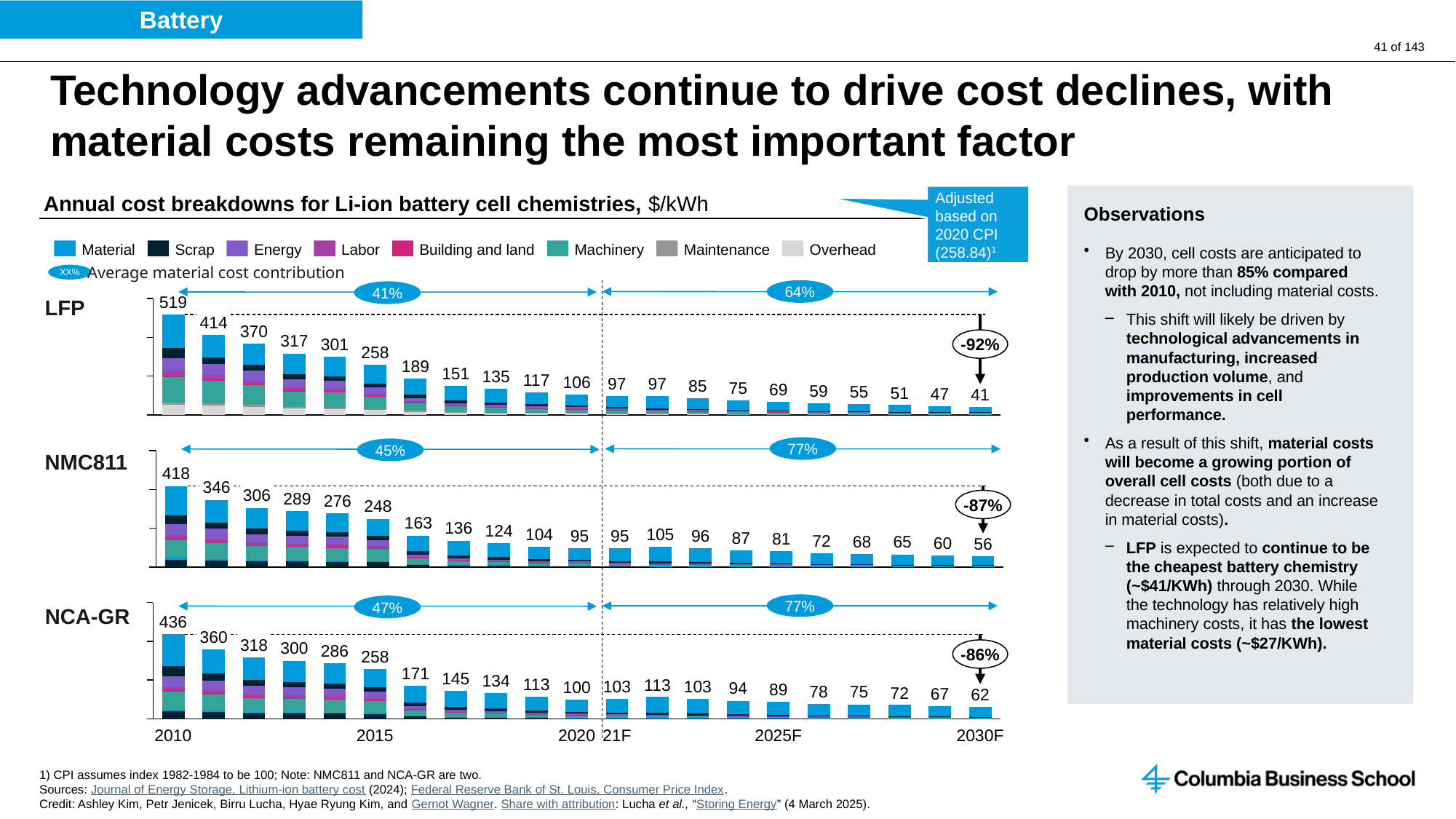
On the LFP chart, do total costs rise or fall from 2010 to 2030F? Fall In 2030F, which chemistry has the higher total cost, NMC811 or NCA-GR? NCA-GR How many series does the legend list? 8 On the NCA-GR chart, what is the total cost in 2030F? 62 On the NMC811 chart, what is the total cost in 2030F? 56 What percentage decline is shown for the LFP chart? -92% On the LFP chart, what is the total cost in 2010? 519 On the LFP chart, which year has the highest total cost? 2010 On the NMC811 chart, which year has the lowest total cost? 2030F On the LFP chart, what is the difference between the 2010 total (519) and the 2030F total (41)? 478 What kind of chart is used for each chemistry? Stacked bar chart On the NCA-GR chart, what is the total cost in 2015? 258